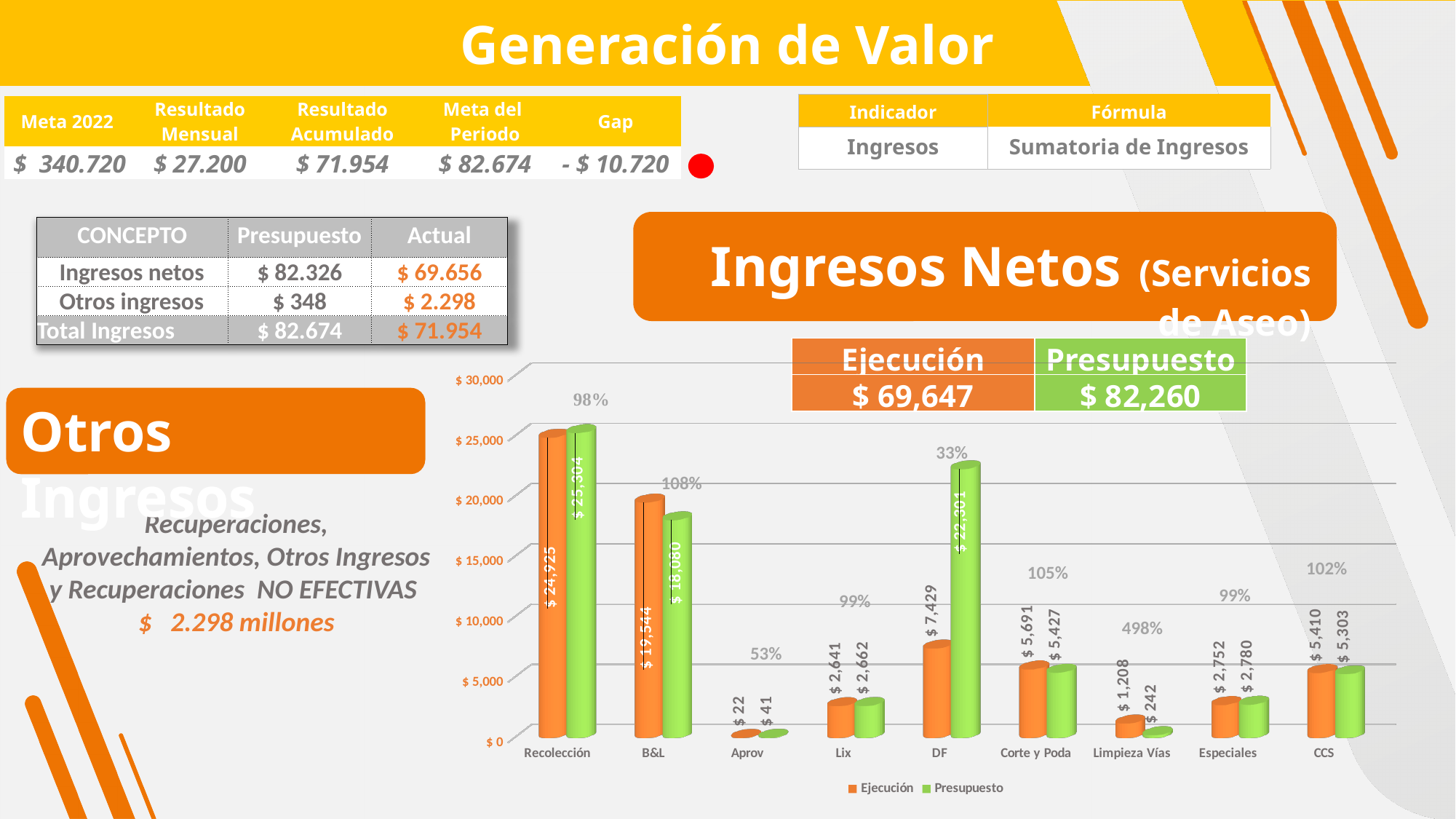
What kind of chart is shown on the slide? bar chart Is the Ejecución value for Recolección greater or less than $ 20,000? greater What is the Ejecución value for Limpieza Vías? $ 1,208 What is the Ejecución value for B&L? $ 19,544 Which category has the lowest Ejecución value? Aprov How many categories are shown on the x axis of the chart? 9 What is the difference between the Ejecución and Presupuesto values for CCS? $ 107 Which category has the highest Ejecución value? Recolección For DF, which is larger: the Ejecución value or the Presupuesto value? Presupuesto How many series does the chart legend list? 2 What is the Presupuesto value for Corte y Poda? $ 5,427 What is the Presupuesto value for Especiales? $ 2,780